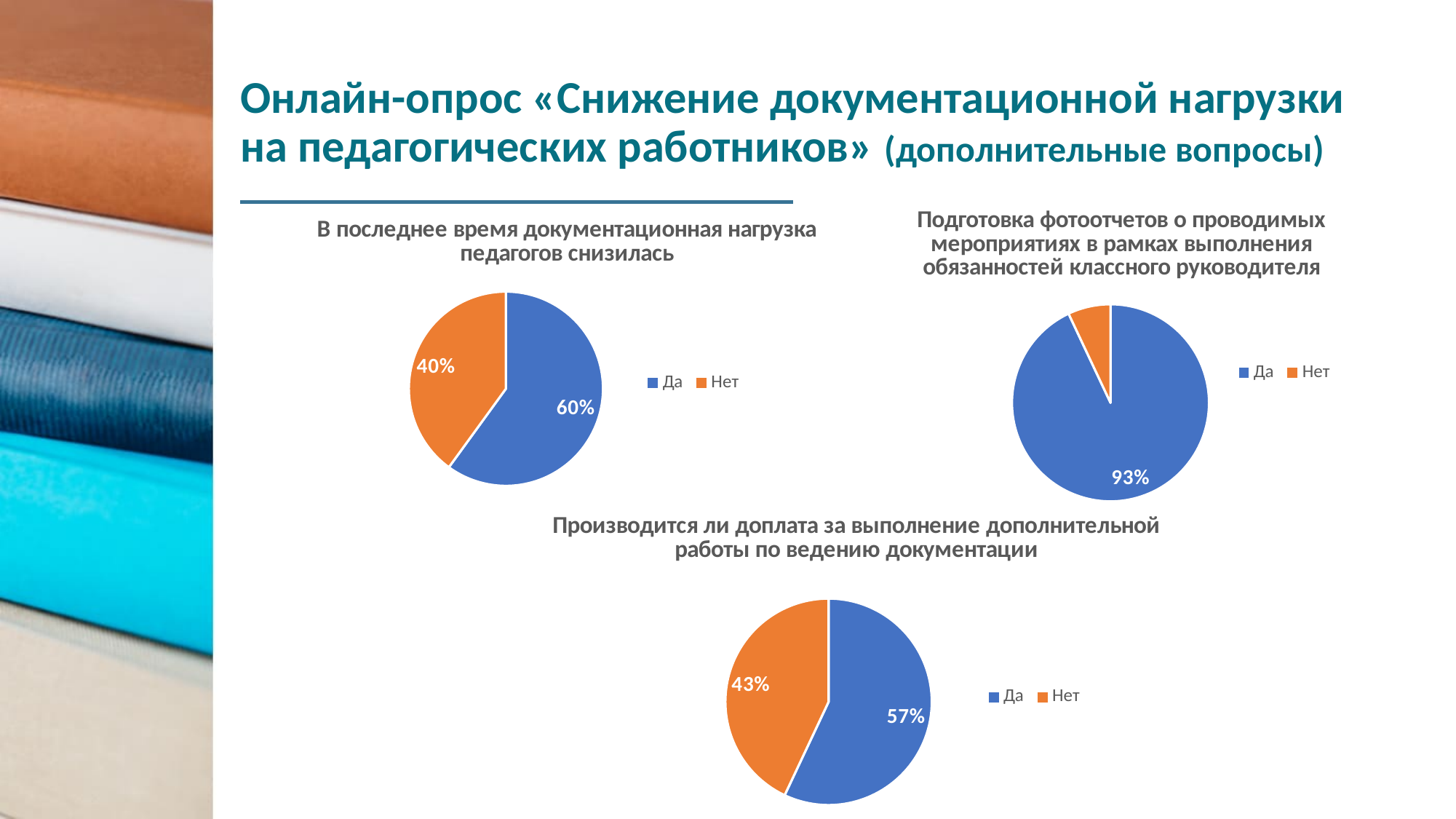
In the chart titled «В последнее время документационная нагрузка педагогов снизилась», which answer has the larger share, «Да» or «Нет»? Да What type of chart is used for «Производится ли доплата за выполнение дополнительной работы по ведению документации»? Pie chart In the chart titled «Подготовка фотоотчетов о проводимых мероприятиях в рамках выполнения обязанностей классного руководителя», which answer has the smallest share? Нет In the chart titled «В последнее время документационная нагрузка педагогов снизилась», what share of respondents answered «Нет»? 40% In the chart titled «В последнее время документационная нагрузка педагогов снизилась», what colour represents the «Нет» answer? Orange In the chart titled «В последнее время документационная нагрузка педагогов снизилась», what share of respondents answered «Да»? 60% In the chart titled «Подготовка фотоотчетов о проводимых мероприятиях в рамках выполнения обязанностей классного руководителя», what share of respondents answered «Да»? 93% In the chart titled «В последнее время документационная нагрузка педагогов снизилась», what is the difference in percentage points between the «Да» and «Нет» shares? 20 In the chart titled «Производится ли доплата за выполнение дополнительной работы по ведению документации», what share of respondents answered «Нет»? 43% How many entries does the legend of the chart titled «Подготовка фотоотчетов о проводимых мероприятиях в рамках выполнения обязанностей классного руководителя» list? 2 In the chart titled «Производится ли доплата за выполнение дополнительной работы по ведению документации», what share of respondents answered «Да»? 57% In the chart titled «Производится ли доплата за выполнение дополнительной работы по ведению документации», what is the difference in percentage points between the «Да» and «Нет» shares? 14